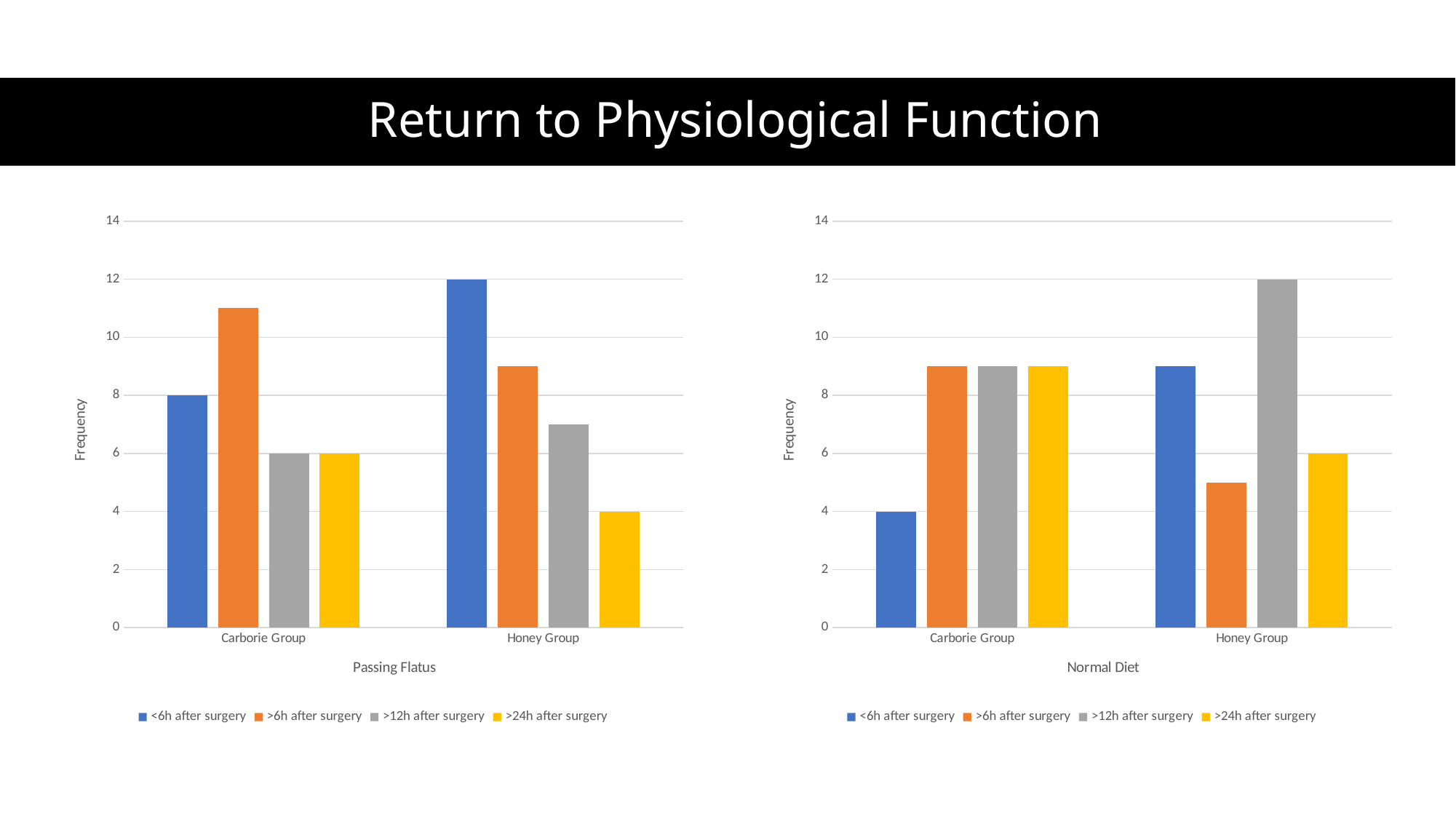
In the Passing Flatus chart, which series has the highest bar in the Honey Group? <6h after surgery What type of chart is the Passing Flatus chart? Bar chart In the Passing Flatus chart, what is the frequency for >24h after surgery in the Honey Group? 4 In the Passing Flatus chart, is the value for >6h after surgery in the Carborie Group greater or less than 10? greater How many series does the legend of the Normal Diet chart list? 4 In the Passing Flatus chart, what is the frequency for <6h after surgery in the Carborie Group? 8 In the Normal Diet chart, what is the frequency for <6h after surgery in the Carborie Group? 4 In the Normal Diet chart, is the value for >6h after surgery in the Honey Group greater or less than 6? less In the Normal Diet chart, which series has the lowest bar in the Carborie Group? <6h after surgery In the Passing Flatus chart, which is larger for the Carborie Group: <6h after surgery or >12h after surgery? <6h after surgery In the Normal Diet chart, what is the frequency for >12h after surgery in the Honey Group? 12 In the Passing Flatus chart, what is the frequency for <6h after surgery in the Honey Group? 12